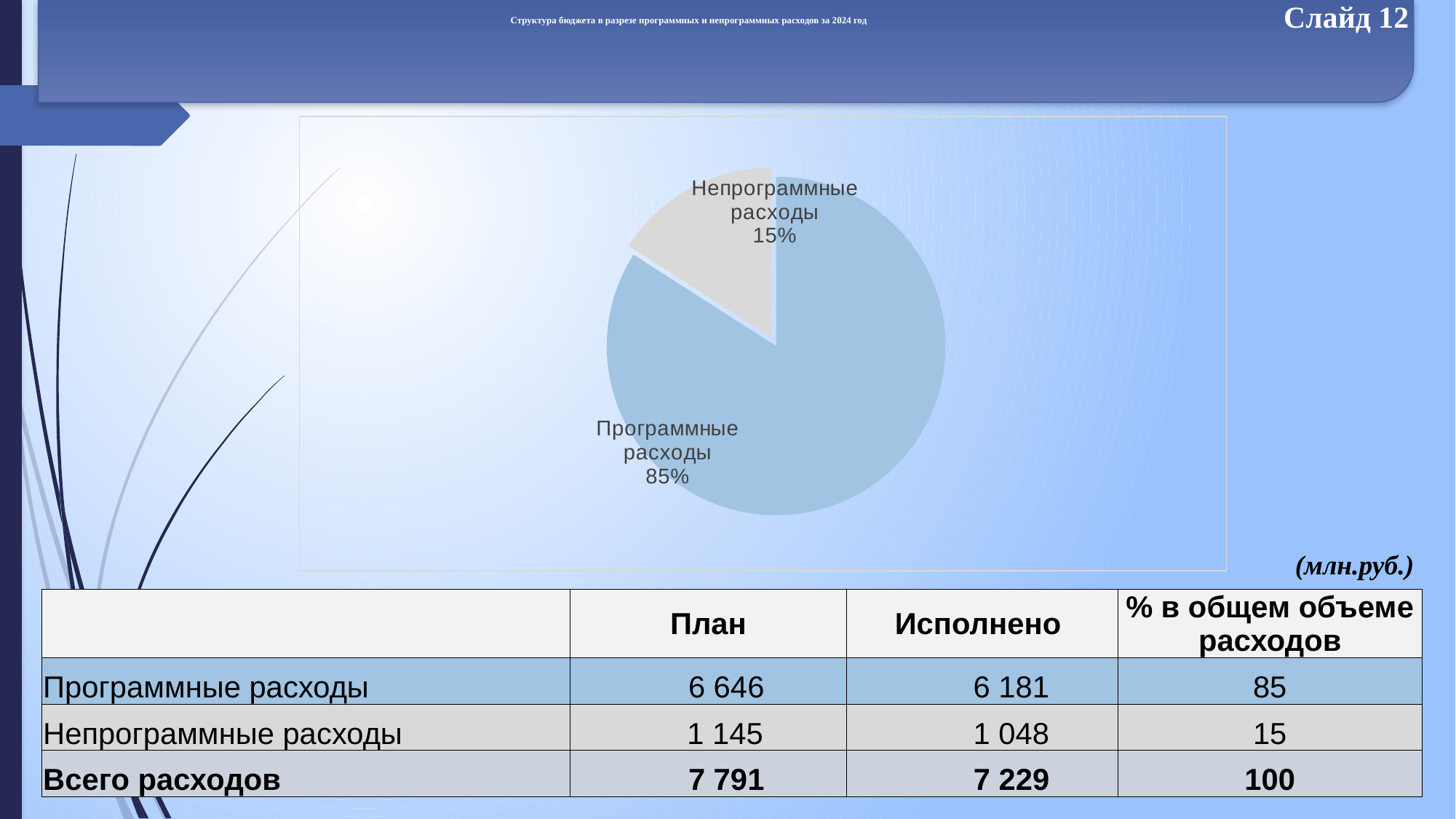
How many slices does the pie chart have? 2 What share of the pie is labelled Непрограммные расходы? 15% What is the combined share of the two slices in the pie chart? 100% What kind of chart is shown on the slide? pie chart Which slice of the pie chart is the smallest? Непрограммные расходы Which is larger in the pie chart: Программные расходы or Непрограммные расходы? Программные расходы Which slice of the pie chart is the largest? Программные расходы What colour is the Программные расходы slice in the pie chart? light blue What share of the pie is labelled Программные расходы? 85% By how many percentage points does the Программные расходы slice exceed the Непрограммные расходы slice? 70 What colour is the Непрограммные расходы slice in the pie chart? grey